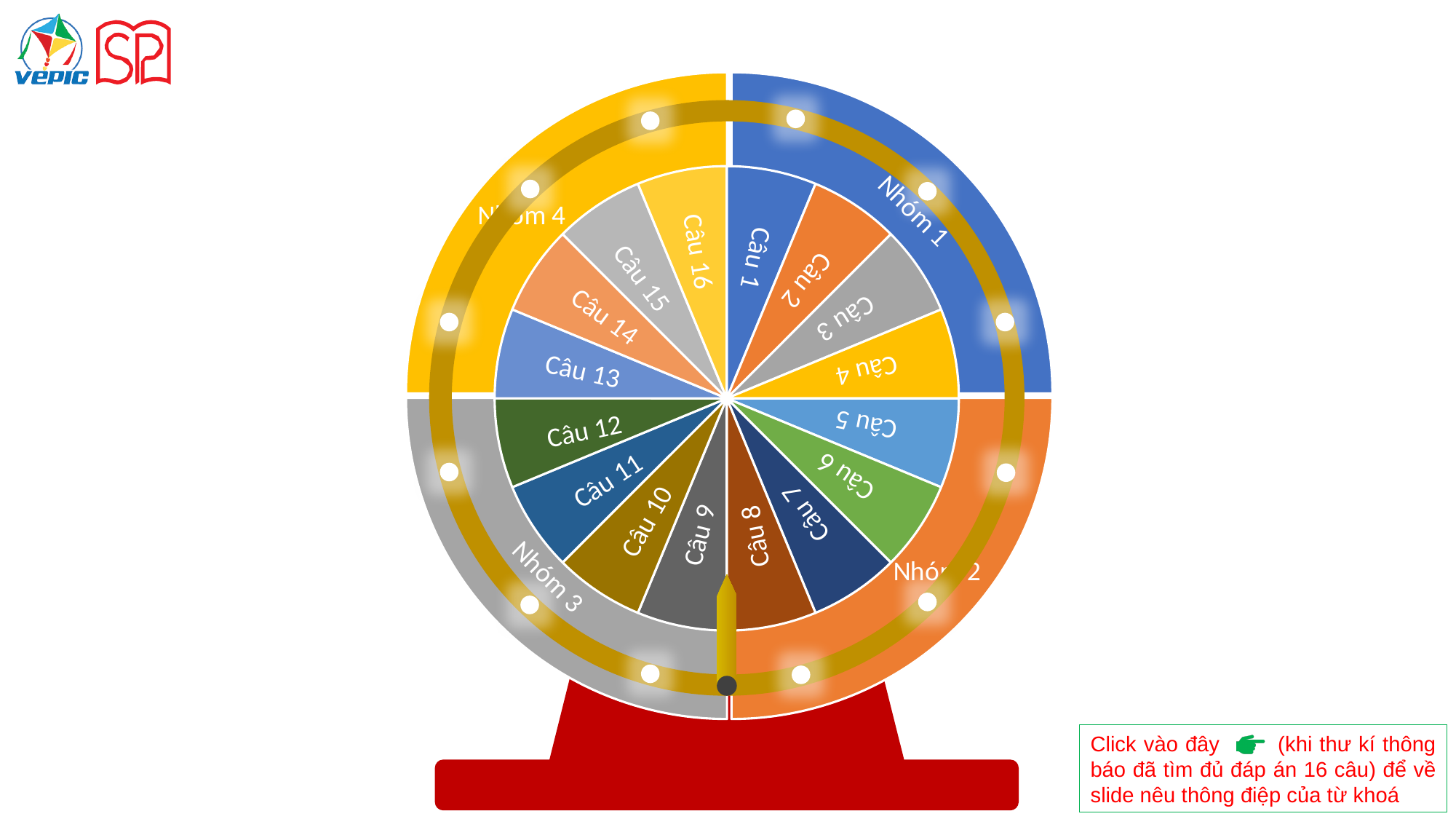
What is the label of the last slice of the inner wheel, just to the left of the top? Câu 16 How many slices does the inner wheel have? 16 Which group label appears on the blue segment of the outer ring? Nhóm 1 What kind of chart is the wheel in the centre of the slide built from? pie chart How many group segments (Nhóm) does the outer ring of the wheel have? 4 What is the label of the first slice of the inner wheel, just to the right of the top? Câu 1 Which group label appears on the yellow segment of the outer ring? Nhóm 4